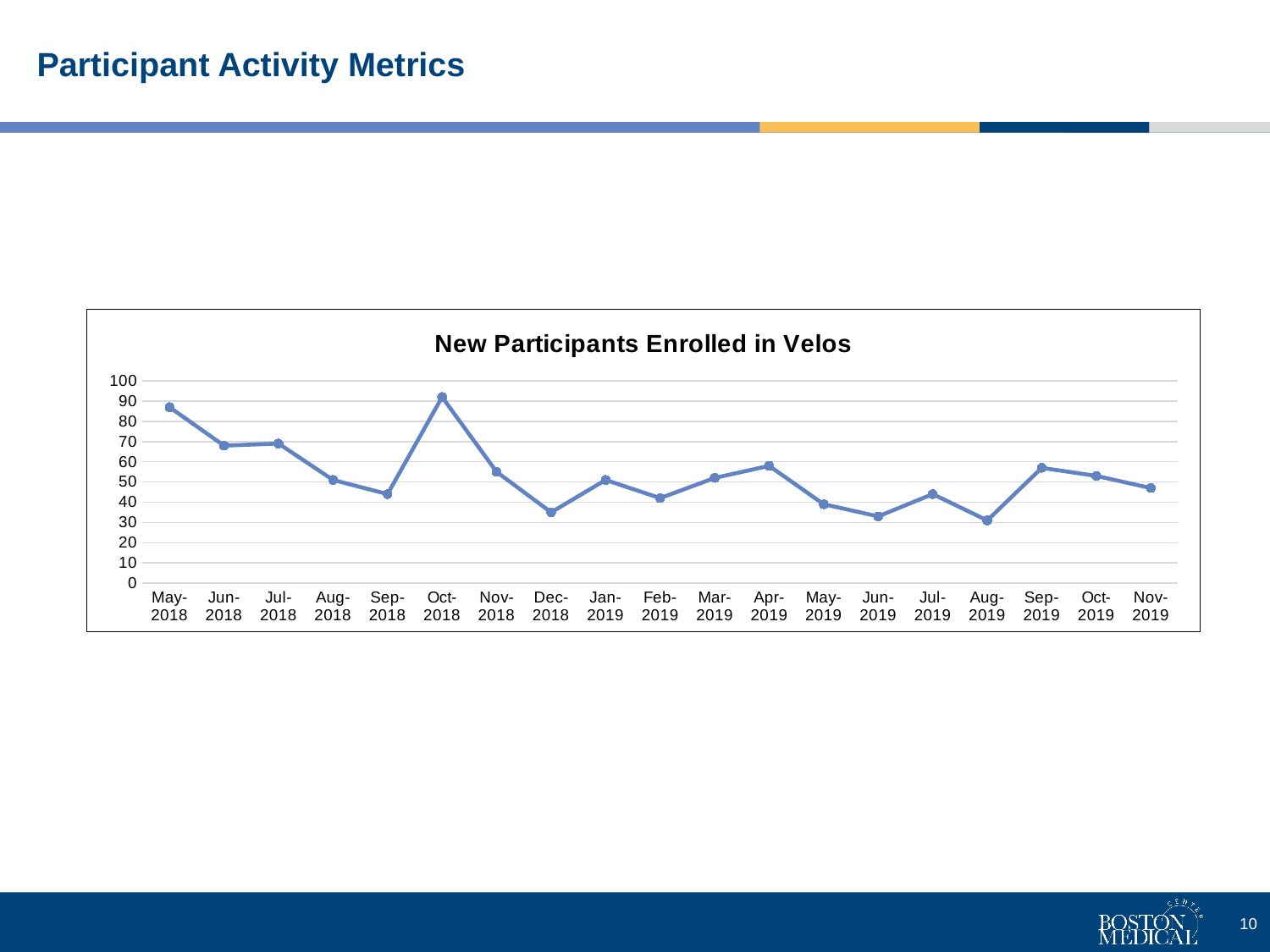
What is the title of the chart? New Participants Enrolled in Velos Is the value for Dec-2018 greater or less than 40? less Do the values rise or fall from May-2018 to Sep-2018? fall What is the maximum value shown on the vertical axis? 100 How many monthly data points are plotted on the chart? 19 What kind of chart is shown on the slide? line chart Is the value for Aug-2019 greater or less than 40? less Is the value for Oct-2018 greater or less than 80? greater Which month has the highest number of new participants enrolled? Oct-2018 Which is larger, the value for Oct-2018 or the value for Dec-2018? Oct-2018 Which is larger, the value for Apr-2019 or the value for Jun-2019? Apr-2019